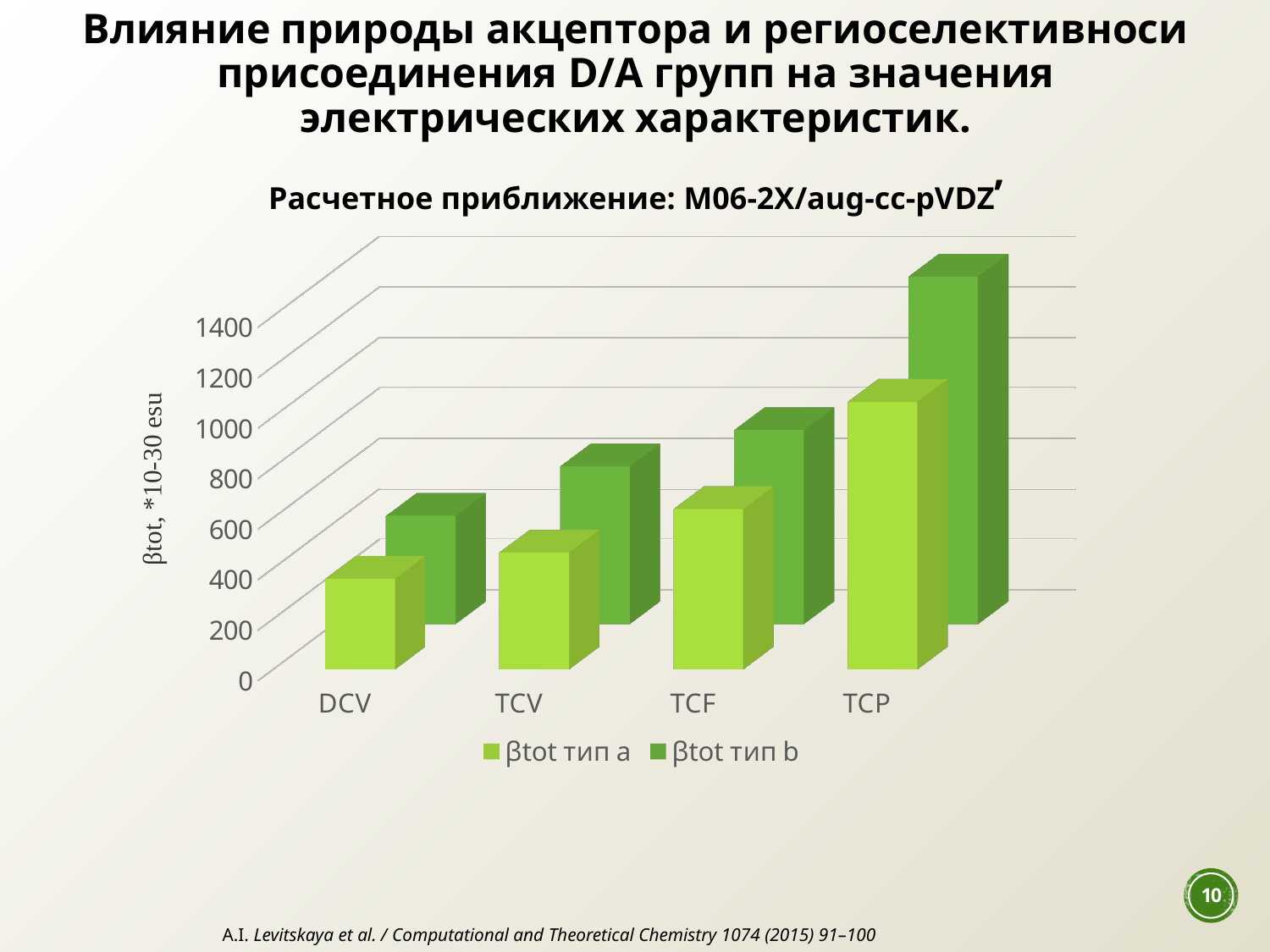
How many series does the chart legend list? 2 Is the value of βtot тип a for TCP greater or less than 800? greater What kind of chart is shown on the slide? bar chart Which is larger: βtot тип b for TCF or βtot тип a for DCV? βtot тип b for TCF Which category has the lowest value for the series βtot тип a? DCV Is the value of βtot тип a for TCV greater or less than 800? less What is the title of the chart? Расчетное приближение: M06-2X/aug-cc-pVDZ' How many categories are shown on the x axis of the chart? 4 Do the values of βtot тип a rise or fall from DCV to TCP along the x axis? rise Is the value of βtot тип a for DCV greater or less than 600? less Which category has the highest value for the series βtot тип b? TCP